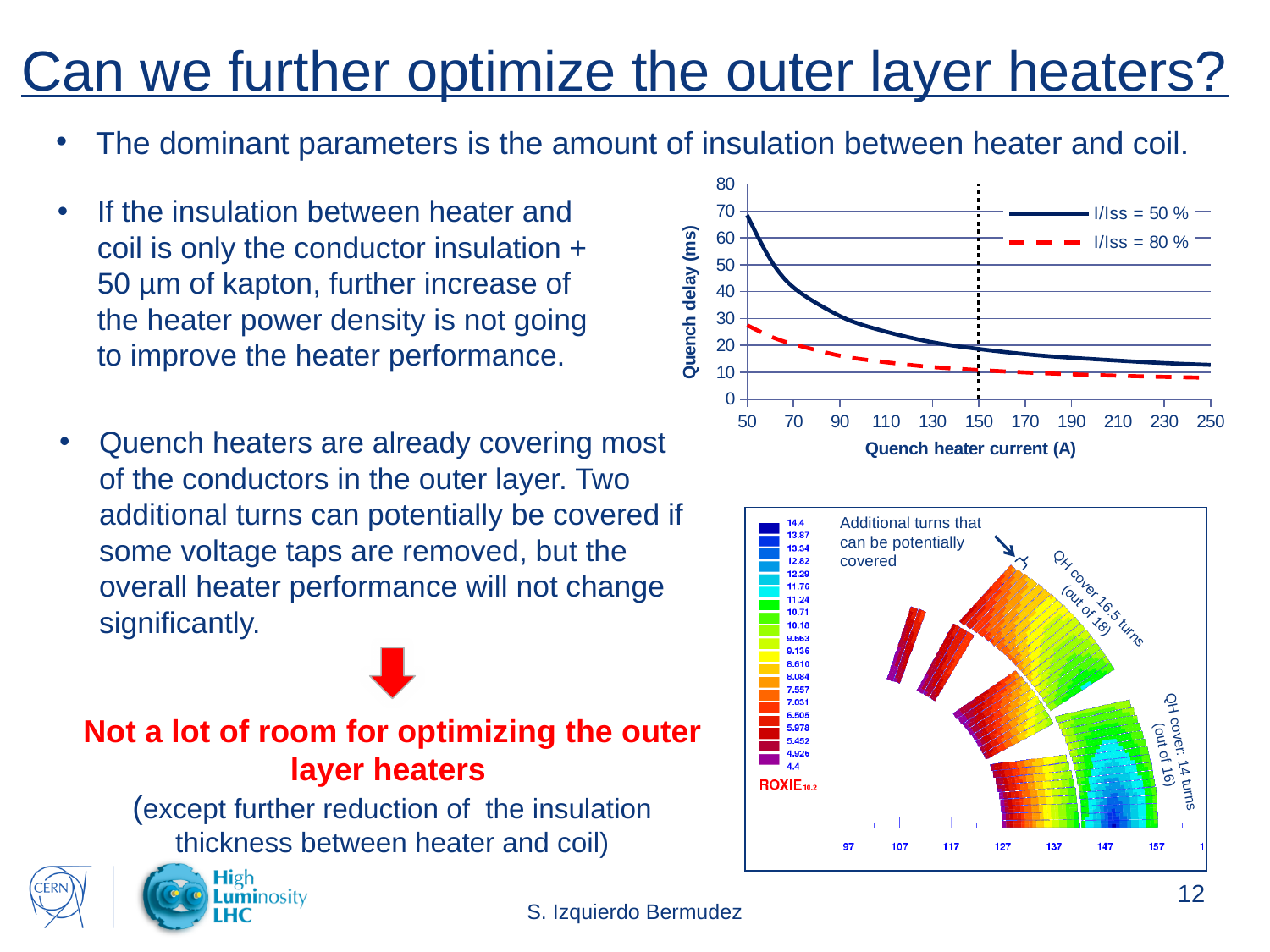
In the quench delay chart, does the quench delay rise or fall as the quench heater current increases? fall In the quench delay chart, which series is drawn as a red dashed line? I/Iss = 80 % In the quench delay chart, is the quench delay for I/Iss = 80 % at 50 A greater or less than 20 ms? greater What are the two series named in the legend of the quench delay chart? I/Iss = 50 % and I/Iss = 80 % What type of chart is the 'Quench delay (ms)' vs 'Quench heater current (A)' chart? line chart In the quench delay chart, is the quench delay for I/Iss = 50 % at 250 A greater or less than 10 ms? greater In the quench delay chart, which series has the higher quench delay at a quench heater current of 150 A, I/Iss = 50 % or I/Iss = 80 %? I/Iss = 50 % What is the label of the x axis of the quench delay chart? Quench heater current (A) In the quench delay chart, is the quench delay for I/Iss = 50 % at 150 A greater or less than 30 ms? less How many series does the legend of the quench delay chart list? 2